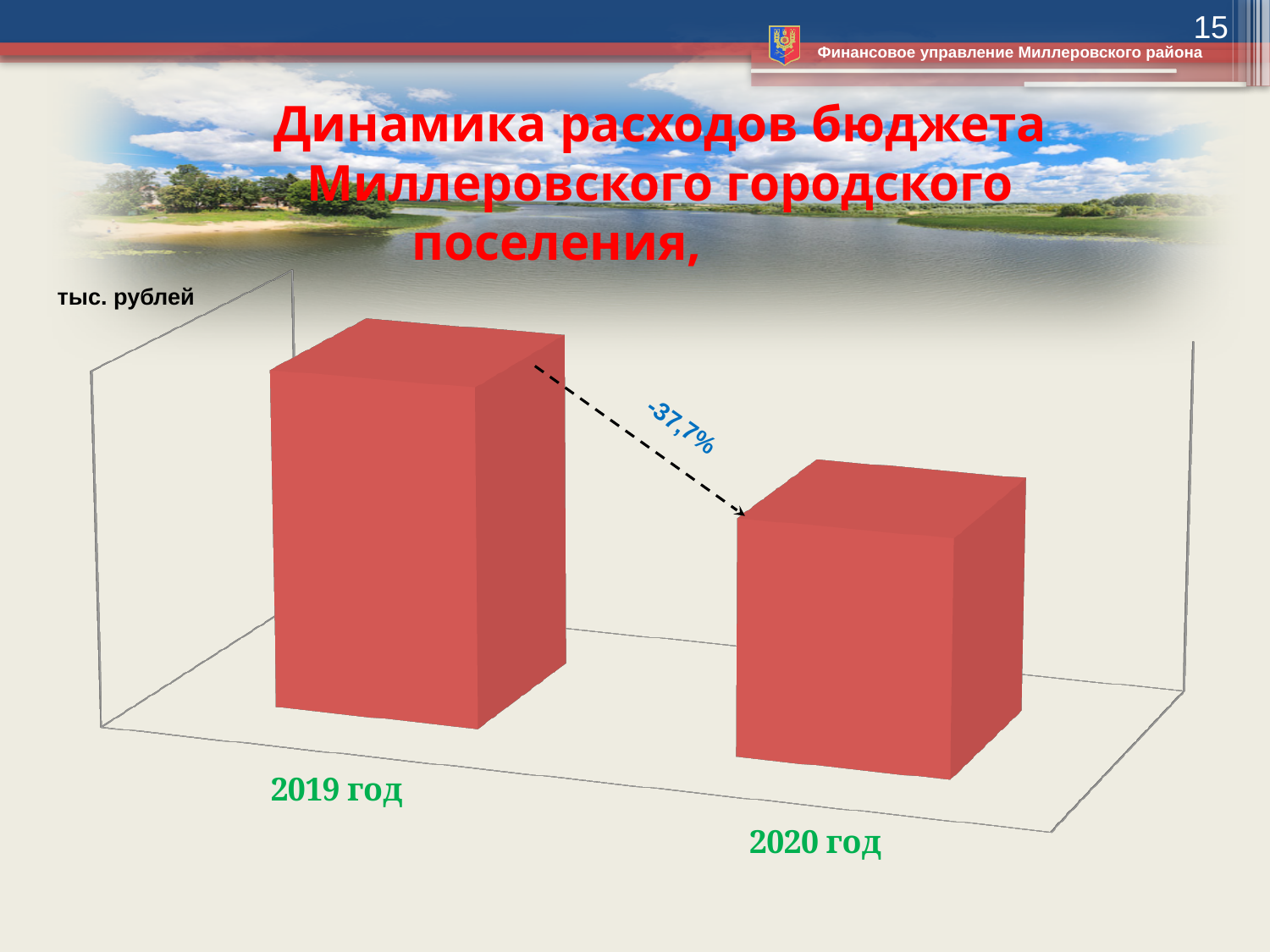
How many categories (bars) does the chart show? 2 Do the values rise or fall from 2019 год to 2020 год? fall Which year has the highest bar in the chart? 2019 год In what units are the chart values expressed, according to the label on the slide? тыс. рублей What kind of chart is shown on the slide? bar chart Which year has the lowest bar in the chart? 2020 год Which is larger, the bar for 2019 год or the bar for 2020 год? 2019 год What percentage change is annotated on the arrow between the 2019 and 2020 bars? -37,7%